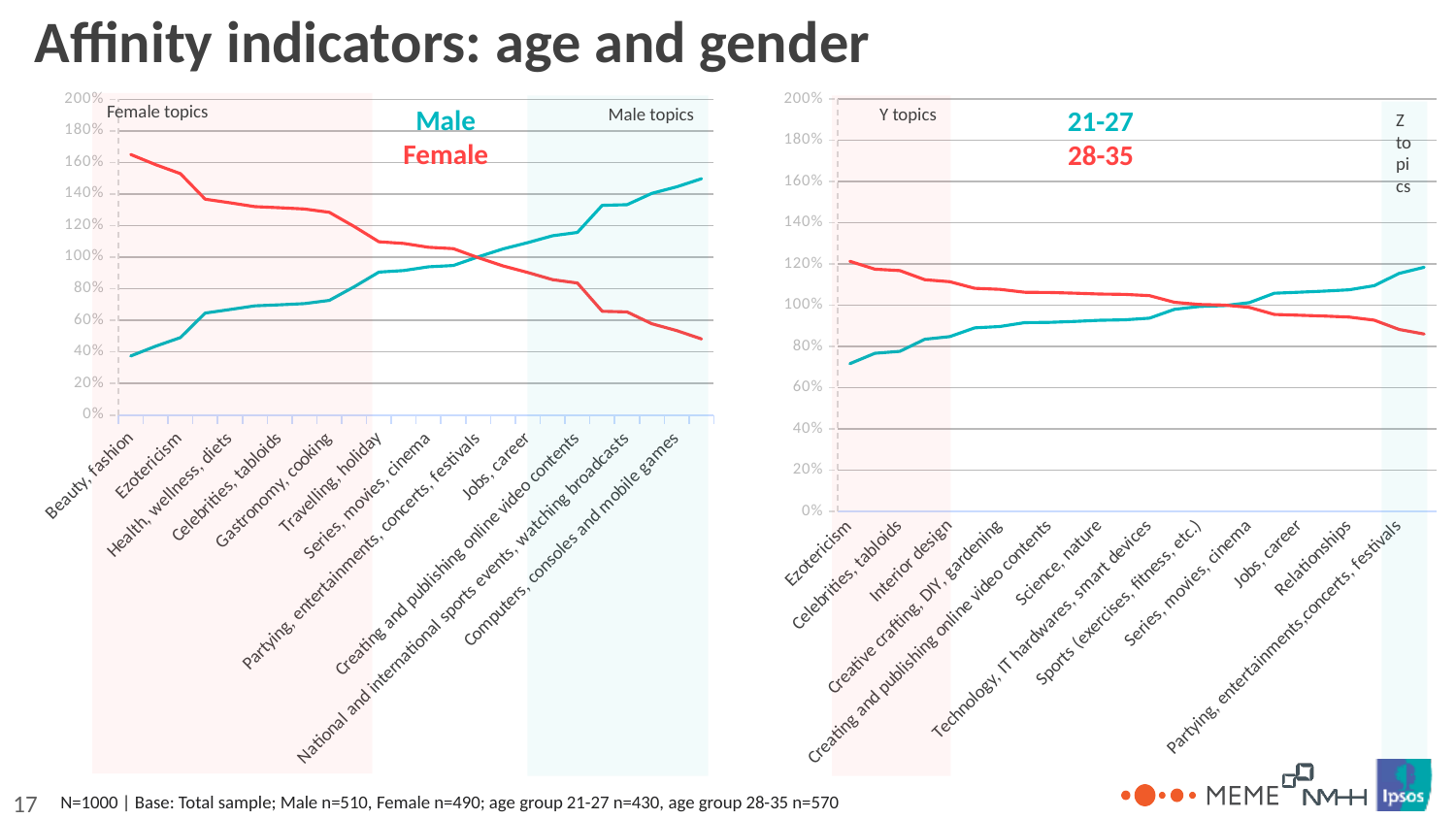
In the left chart, which topic has the lowest Male value? Beauty, fashion In the right chart, does the 28-35 line rise or fall from left to right across the topics? Falls In the left chart, which is larger for Computers, consoles and mobile games: the Male value or the Female value? Male What kind of chart is the left chart (Male vs Female)? Line chart In the left chart, which topic has the highest Female value? Beauty, fashion How many series does the legend of the left chart list? 2 In the left chart, does the Male line rise or fall from left to right across the topics? Rises In the left chart, is the Female value for Beauty, fashion greater or less than 140%? greater In the left chart, is the Female value for Computers, consoles and mobile games greater or less than 60%? less In the right chart, is the 28-35 value for Ezotericism greater or less than 100%? greater